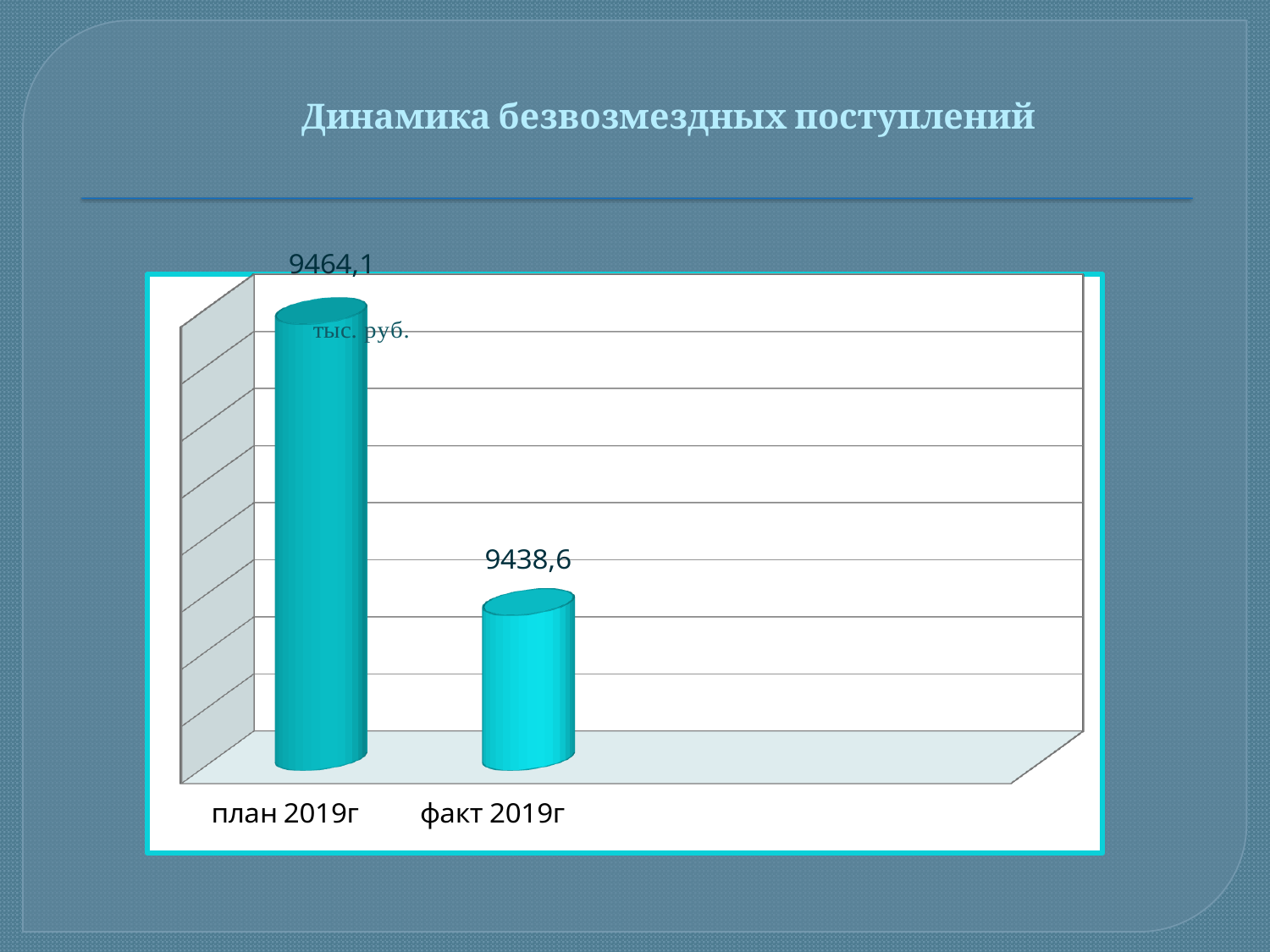
What kind of chart is shown on the slide? bar chart In what units are the values on the chart given? тыс. руб. Which category has the lowest value? факт 2019г What is the value for план 2019г? 9464,1 How many categories are shown on the chart? 2 What is the title of the slide? Динамика безвозмездных поступлений Which is larger, the value for план 2019г or the value for факт 2019г? план 2019г What is the value for факт 2019г? 9438,6 What is the difference between the values for план 2019г and факт 2019г? 25,5 Which category has the highest value? план 2019г Do the values rise or fall from план 2019г to факт 2019г? fall